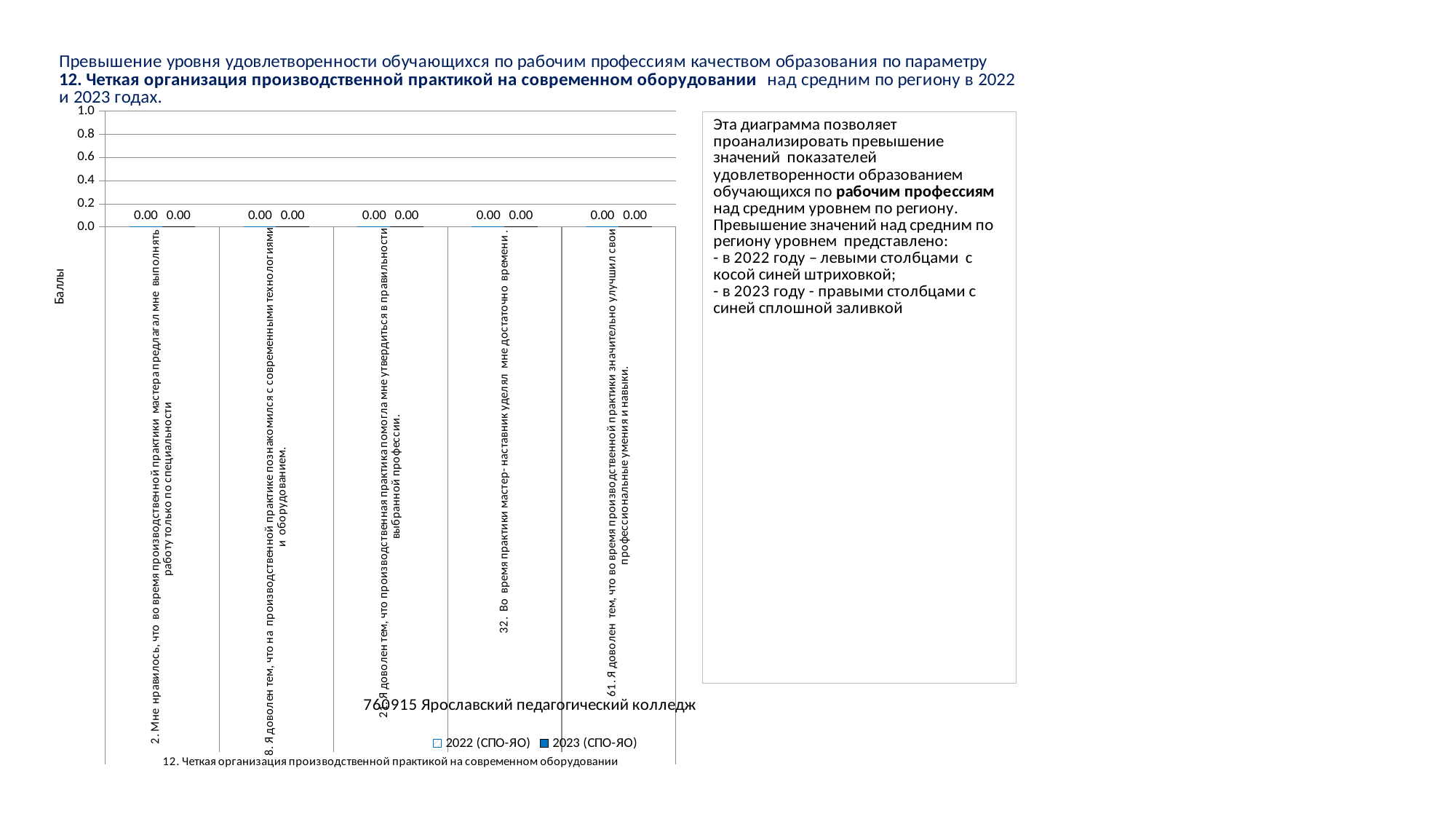
How many categories (questions) are plotted along the x axis of the chart? 5 What is the value of the 2022 (СПО-ЯО) series for category 2 ("Мне нравилось, что во время производственной практики мастер предлагал мне выполнять работу только по специальности")? 0.00 What is the value of the 2023 (СПО-ЯО) series for category 61 ("Я доволен тем, что во время производственной практики значительно улучшил свои профессиональные умения и навыки")? 0.00 How many series does the chart legend list? 2 What is the highest tick value shown on the vertical axis of the chart? 1.0 What kind of chart is shown on the slide? bar chart Is the 2023 (СПО-ЯО) value for category 61 greater or less than 0.2? less What are the two series named in the chart legend? 2022 (СПО-ЯО) and 2023 (СПО-ЯО) What is the value of the 2023 (СПО-ЯО) series for category 8 ("Я доволен тем, что на производственной практике познакомился с современными технологиями и оборудованием")? 0.00 What is the label of the vertical axis of the chart? Баллы What is the value of the 2022 (СПО-ЯО) series for category 32 ("Во время практики мастер-наставник уделял мне достаточно времени")? 0.00 What is the difference between the 2022 (СПО-ЯО) and 2023 (СПО-ЯО) values for category 32? 0.00